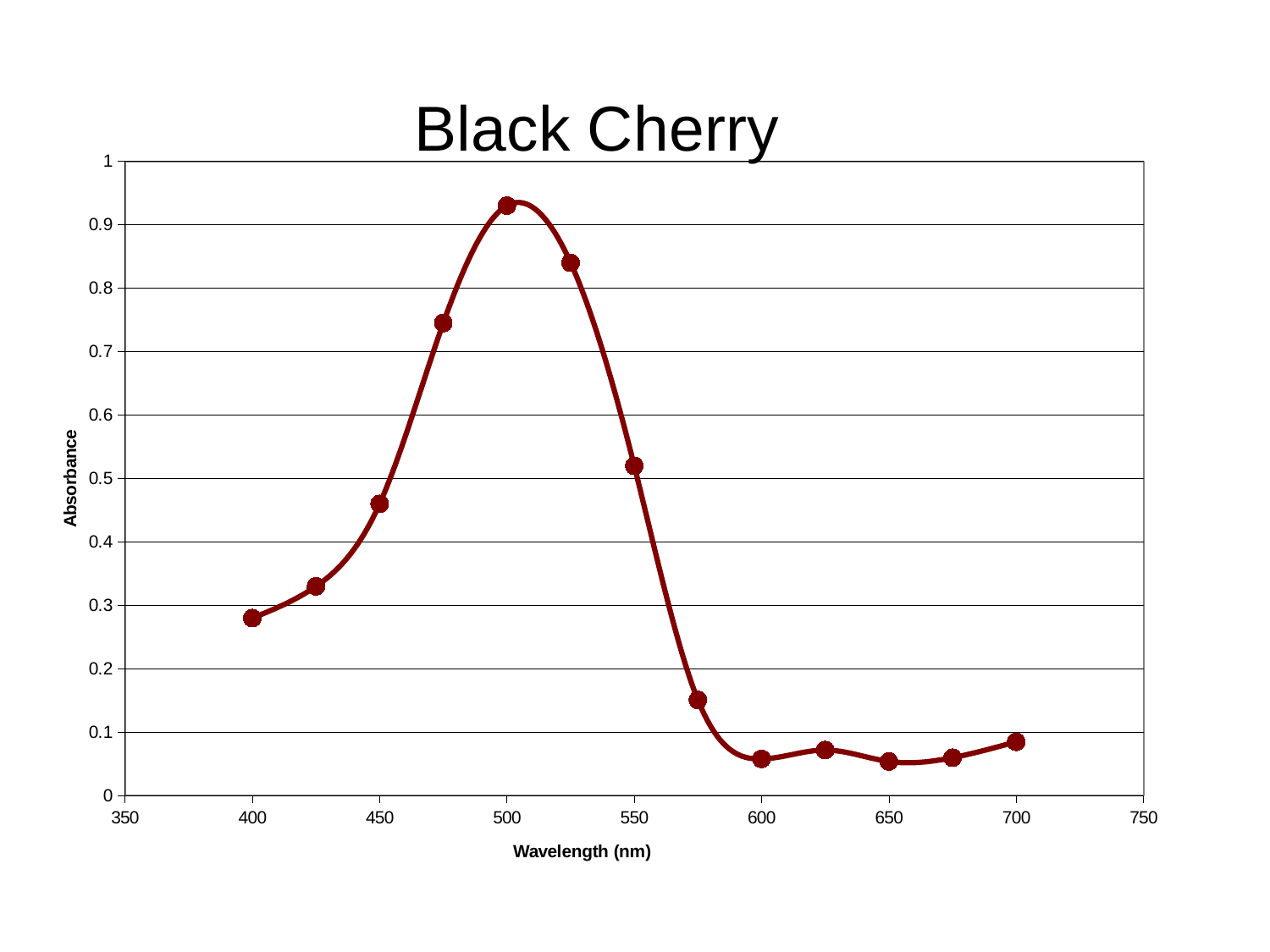
Is the absorbance at 400 nm greater or less than 0.3? less Is the absorbance at 475 nm greater or less than 0.7? greater Is the absorbance at 575 nm greater or less than 0.2? less At which wavelength is the absorbance highest? 500 Does the absorbance rise or fall as the wavelength increases from 400 nm to 500 nm? rise Which has the higher absorbance, 475 nm or 525 nm? 525 nm How many data points are plotted on the line? 13 What is the title of the chart? Black Cherry What is the label of the x axis? Wavelength (nm) What kind of chart is shown on the slide? line chart Does the absorbance rise or fall as the wavelength increases from 500 nm to 575 nm? fall